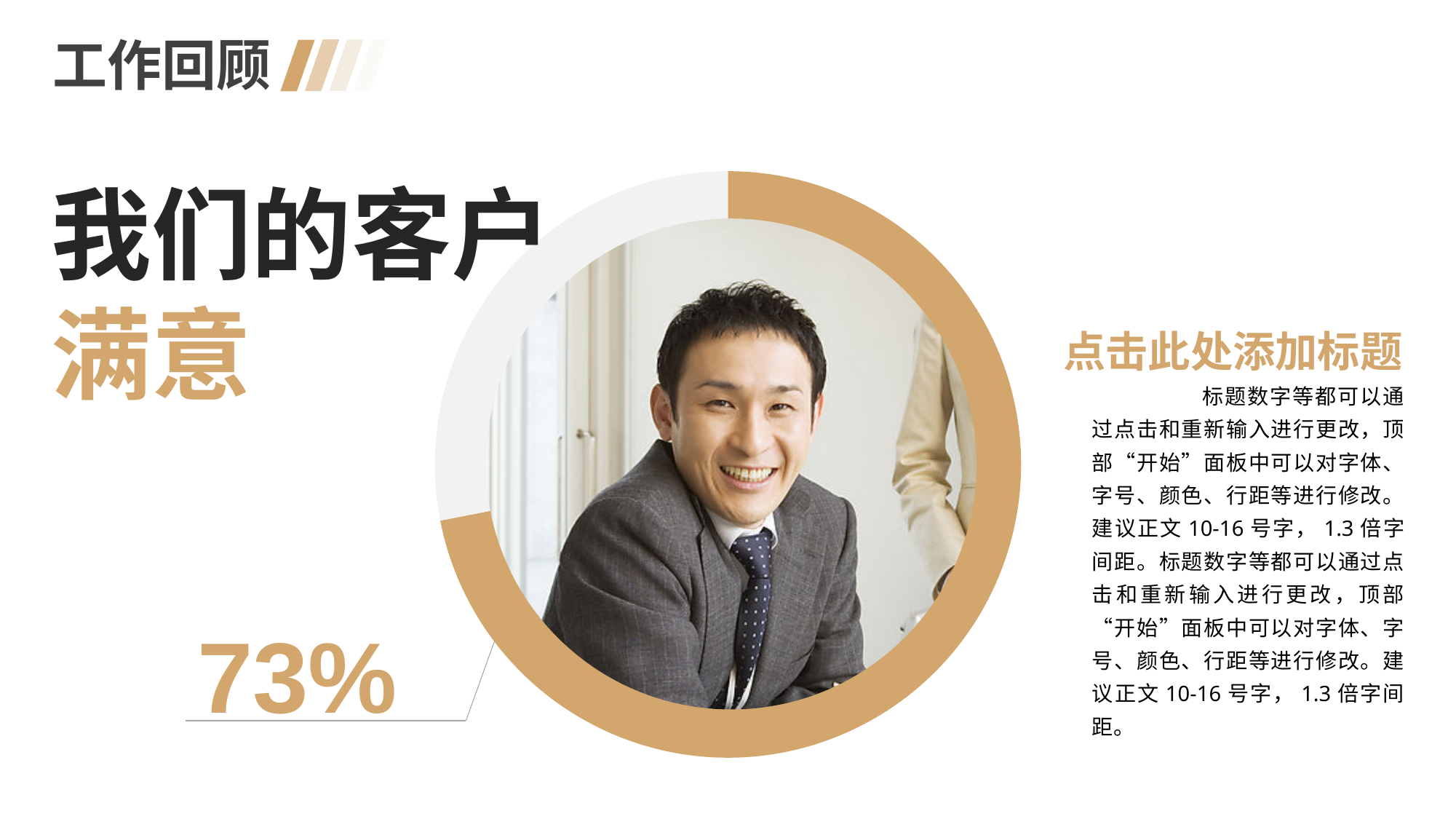
Which segment of the donut chart is larger, the gold one or the grey one? The gold one What percentage is printed next to the donut chart? 73% What kind of chart is shown on the slide? Donut (pie) chart Is the share shown by the gold segment greater or less than 50%? greater How many segments does the donut chart have? 2 What is shown inside the centre of the donut chart? A photo of a smiling man in a suit What colour is the segment of the donut chart that represents 73%? Gold